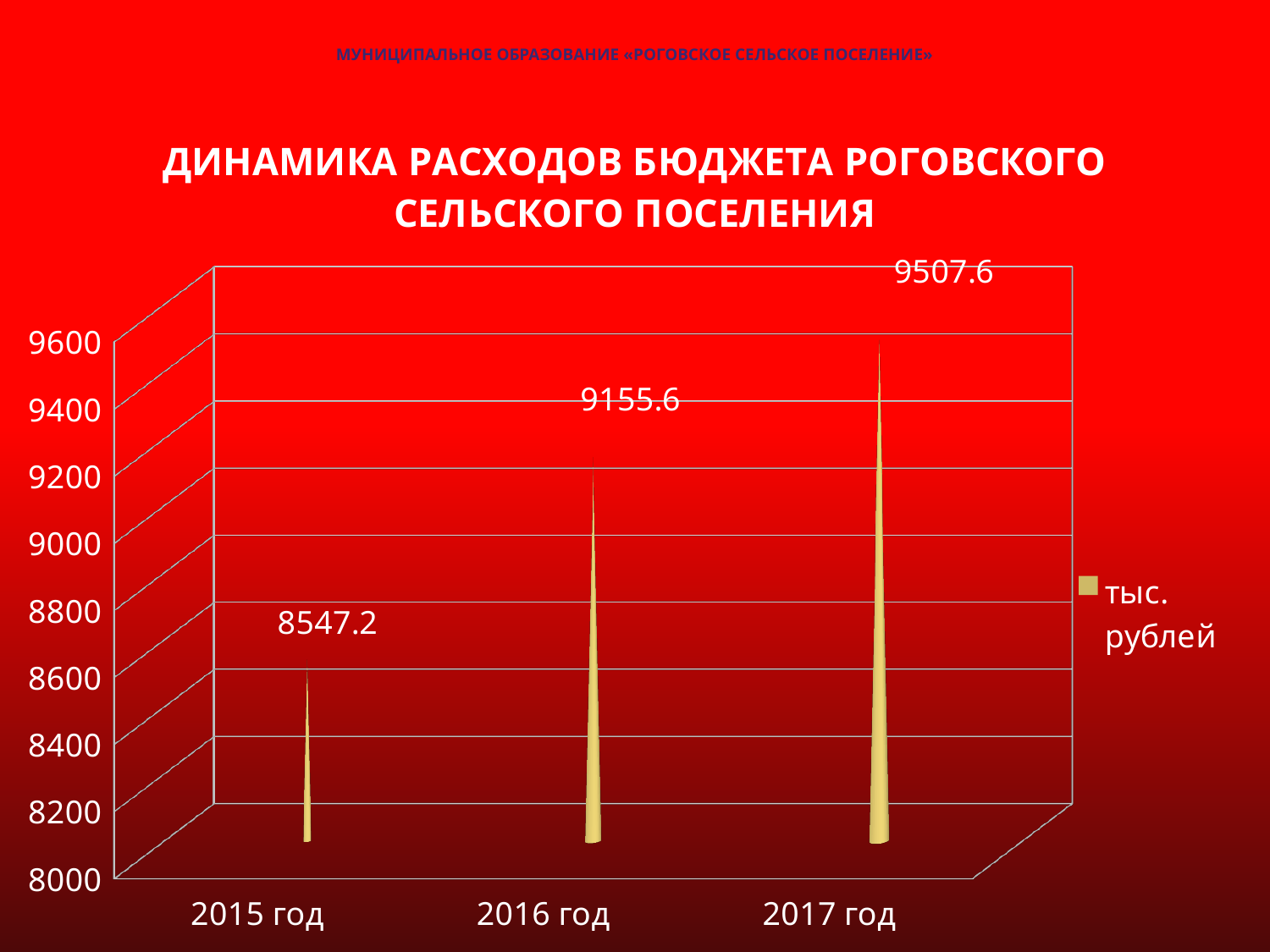
How many categories are shown on the x axis? 3 Do the values rise or fall from 2015 год to 2017 год? rise What is the value for 2015 год? 8547.2 Which is larger, the value for 2015 год or the value for 2016 год? 2016 год What is the legend entry for the series? тыс. рублей Which year has the highest value? 2017 год How many series does the legend list? 1 What is the value for 2017 год? 9507.6 What is the difference between the values for 2016 год and 2015 год? 608.4 What is the value for 2016 год? 9155.6 What is the difference between the values for 2017 год and 2016 год? 352.0 Which year has the lowest value? 2015 год